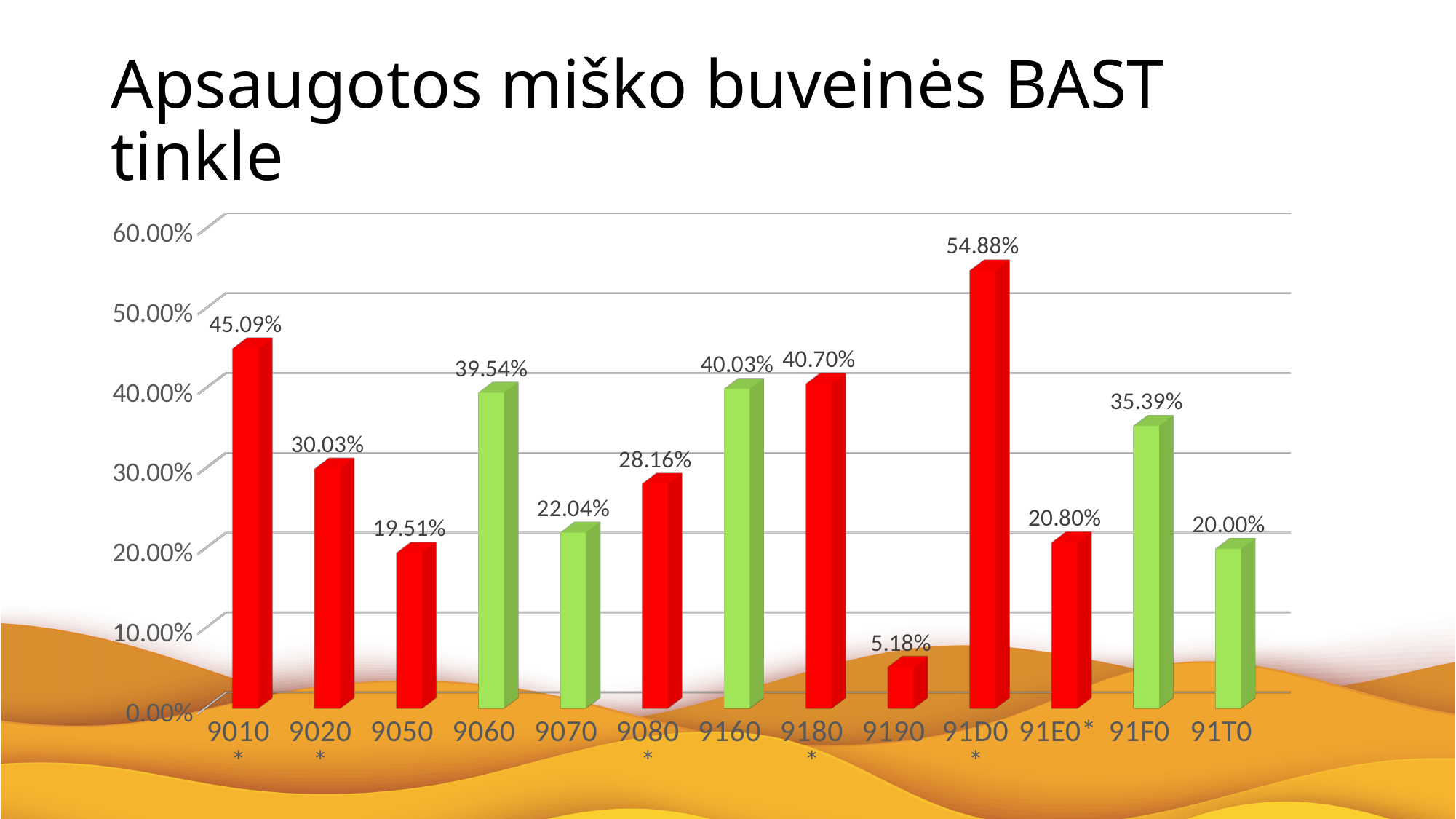
What kind of chart is shown on the slide? Bar chart What is the title of the slide? Apsaugotos miško buveinės BAST tinkle Which category has the highest value? 91D0* Is the value for 9160 greater or less than 30.00%? greater What is the value for 9070? 22.04% Which is larger, the value for 9020* or the value for 9080*? 9020* What is the difference between the values for 9060 and 9050? 20.03% What is the difference between the values for 91D0* and 9010*? 9.79% Which category has the lowest value? 9190 What is the value for 9010*? 45.09% How many categories are shown on the x axis? 13 What is the value for 91F0? 35.39%